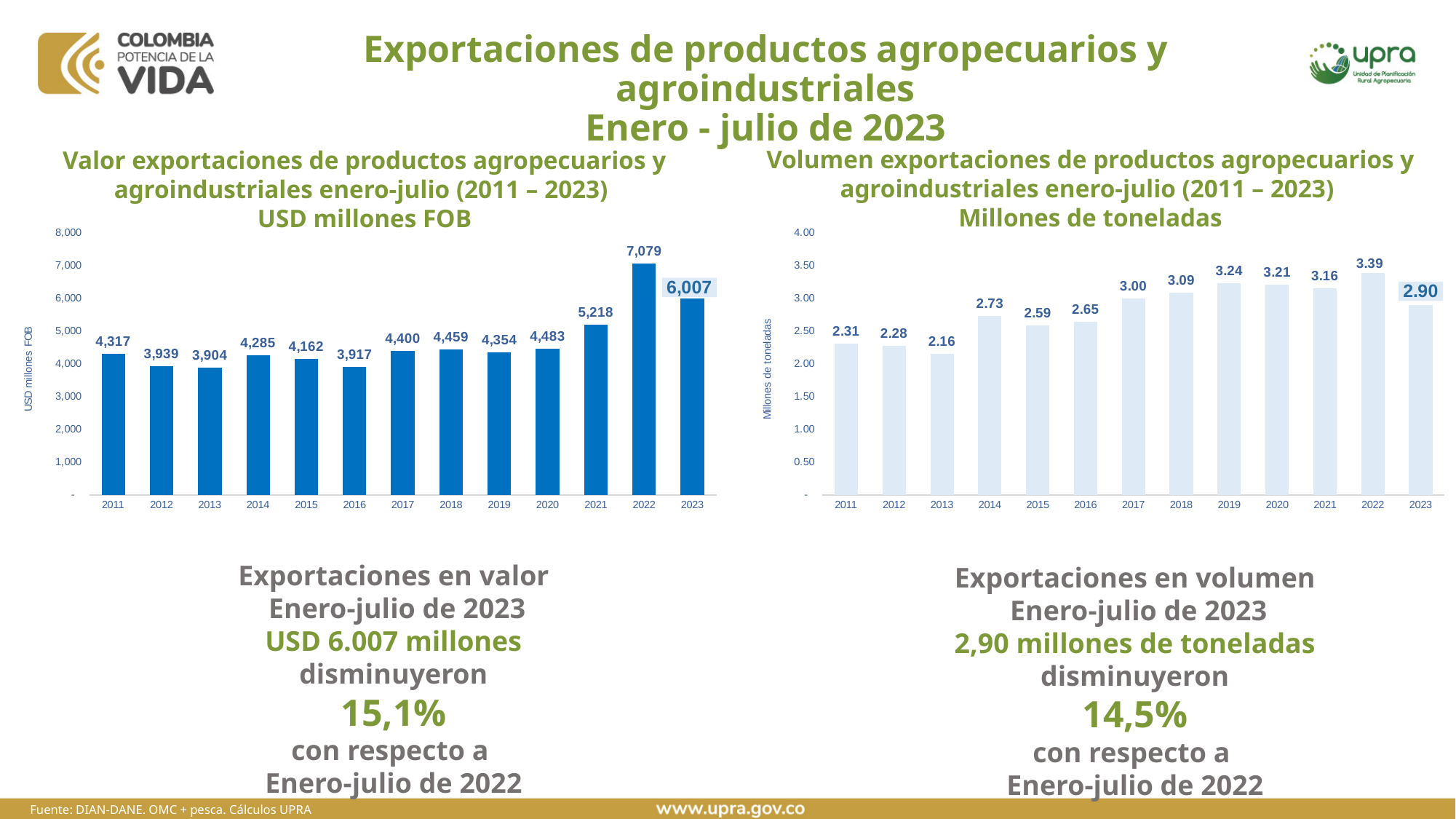
In the right chart (Volumen exportaciones, Millones de toneladas), which year has the lowest value? 2013 In the left chart (Valor exportaciones, USD millones FOB), which year has the lowest value? 2013 In the right chart (Volumen exportaciones, Millones de toneladas), what is the value for 2023? 2.90 In the left chart (Valor exportaciones, USD millones FOB), how many years are plotted? 13 In the right chart (Volumen exportaciones, Millones de toneladas), is the value for 2019 larger or the value for 2020? 2019 In the left chart (Valor exportaciones, USD millones FOB), which year has the highest value? 2022 In the left chart (Valor exportaciones, USD millones FOB), what is the difference between the 2022 and 2023 values? 1,072 In the right chart (Volumen exportaciones, Millones de toneladas), which year has the highest value? 2022 What kind of chart is the right chart (Volumen exportaciones, Millones de toneladas)? Bar chart In the right chart (Volumen exportaciones, Millones de toneladas), what is the difference between the 2022 and 2023 values? 0.49 In the left chart (Valor exportaciones, USD millones FOB), what is the value for 2013? 3,904 In the left chart (Valor exportaciones, USD millones FOB), what is the value for 2022? 7,079